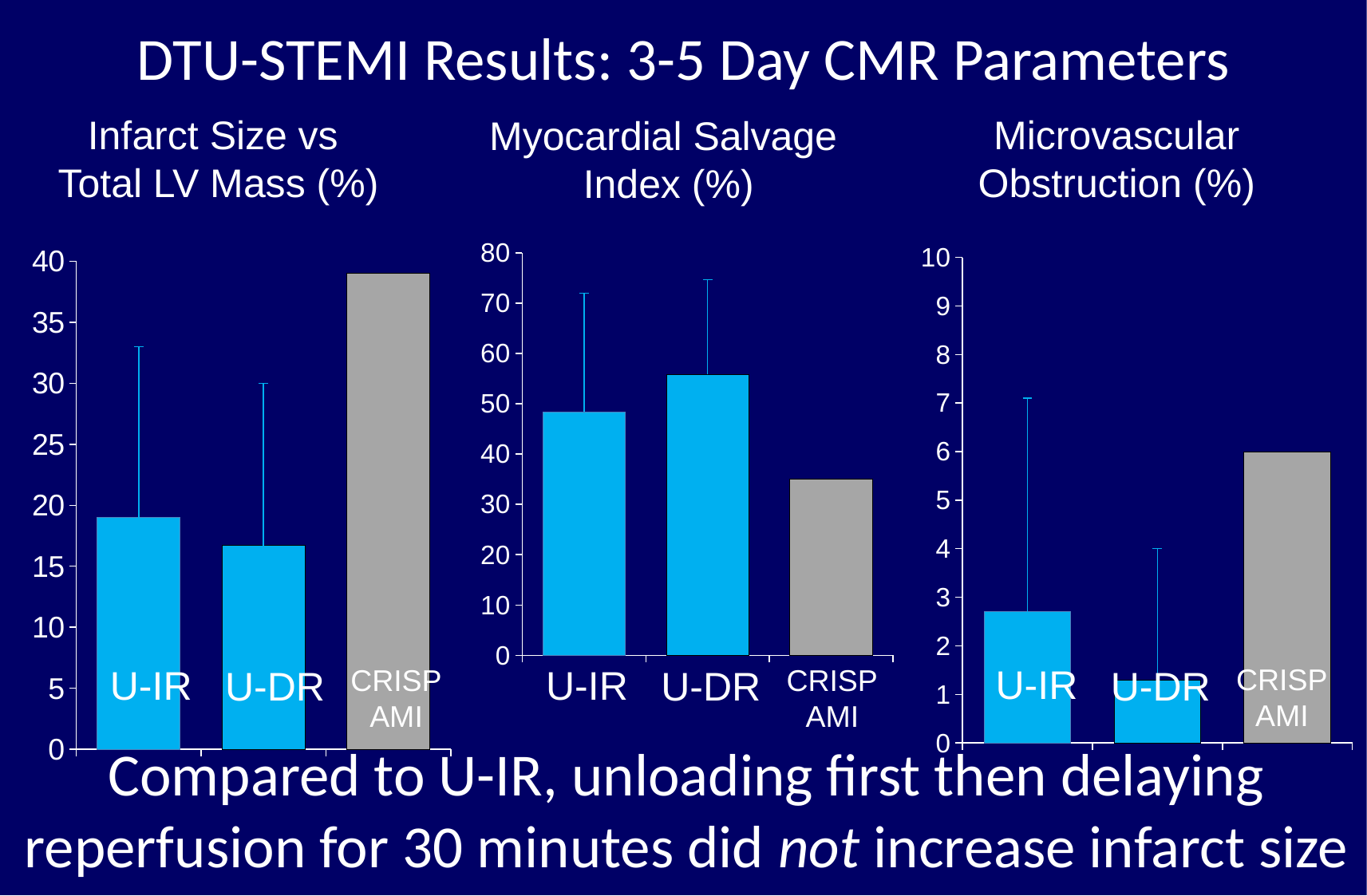
In the Myocardial Salvage Index (%) chart, is the value for CRISP AMI greater or less than 40? less In the Infarct Size vs Total LV Mass (%) chart, is the value for U-DR greater or less than 20? less In the Myocardial Salvage Index (%) chart, which category has the lowest bar? CRISP AMI In the Microvascular Obstruction (%) chart, is the value for U-IR greater or less than 2? greater In the Myocardial Salvage Index (%) chart, which category has the highest bar? U-DR In the Infarct Size vs Total LV Mass (%) chart, which category has the lowest bar? U-DR In the Microvascular Obstruction (%) chart, which is larger, U-IR or U-DR? U-IR In the Infarct Size vs Total LV Mass (%) chart, which category has the highest bar? CRISP AMI In the Microvascular Obstruction (%) chart, which category has the lowest bar? U-DR How many categories are shown in the Infarct Size vs Total LV Mass (%) chart? 3